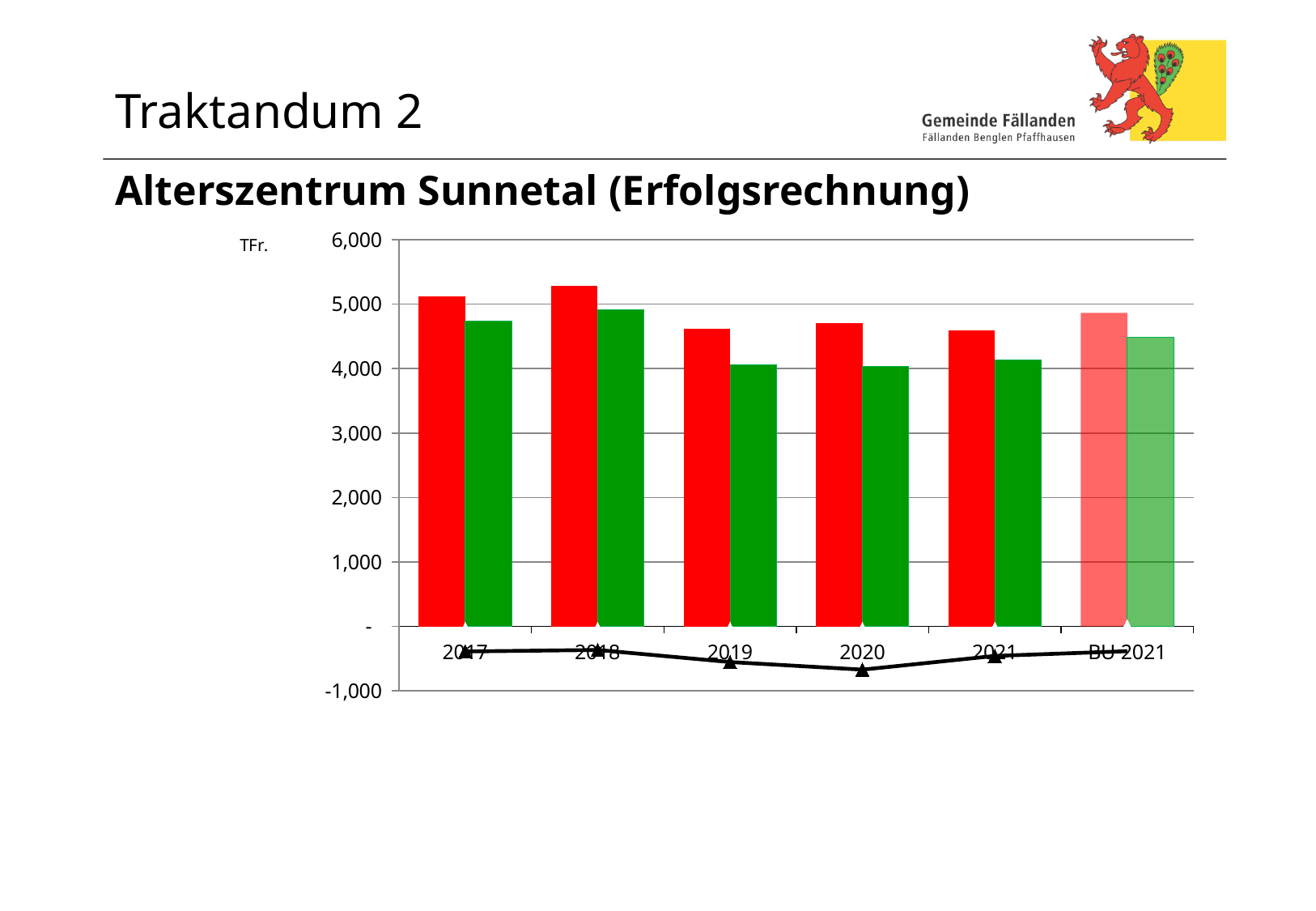
In which category is the green bar the highest? 2018 At which category does the black line reach its lowest point? 2020 How many categories are shown on the x axis of the chart? 6 What unit label is shown next to the vertical axis of the chart? TFr. Is the red bar for 2019 greater or less than 5,000? less Is the green bar for 2017 greater or less than 5,000? less Is the red bar for 2018 greater or less than 5,000? greater What is the title of the chart? Alterszentrum Sunnetal (Erfolgsrechnung) What kind of chart is shown on the slide? combination bar and line chart In which category is the red bar the highest? 2018 In 2019, which bar is taller, the red bar or the green bar? the red bar